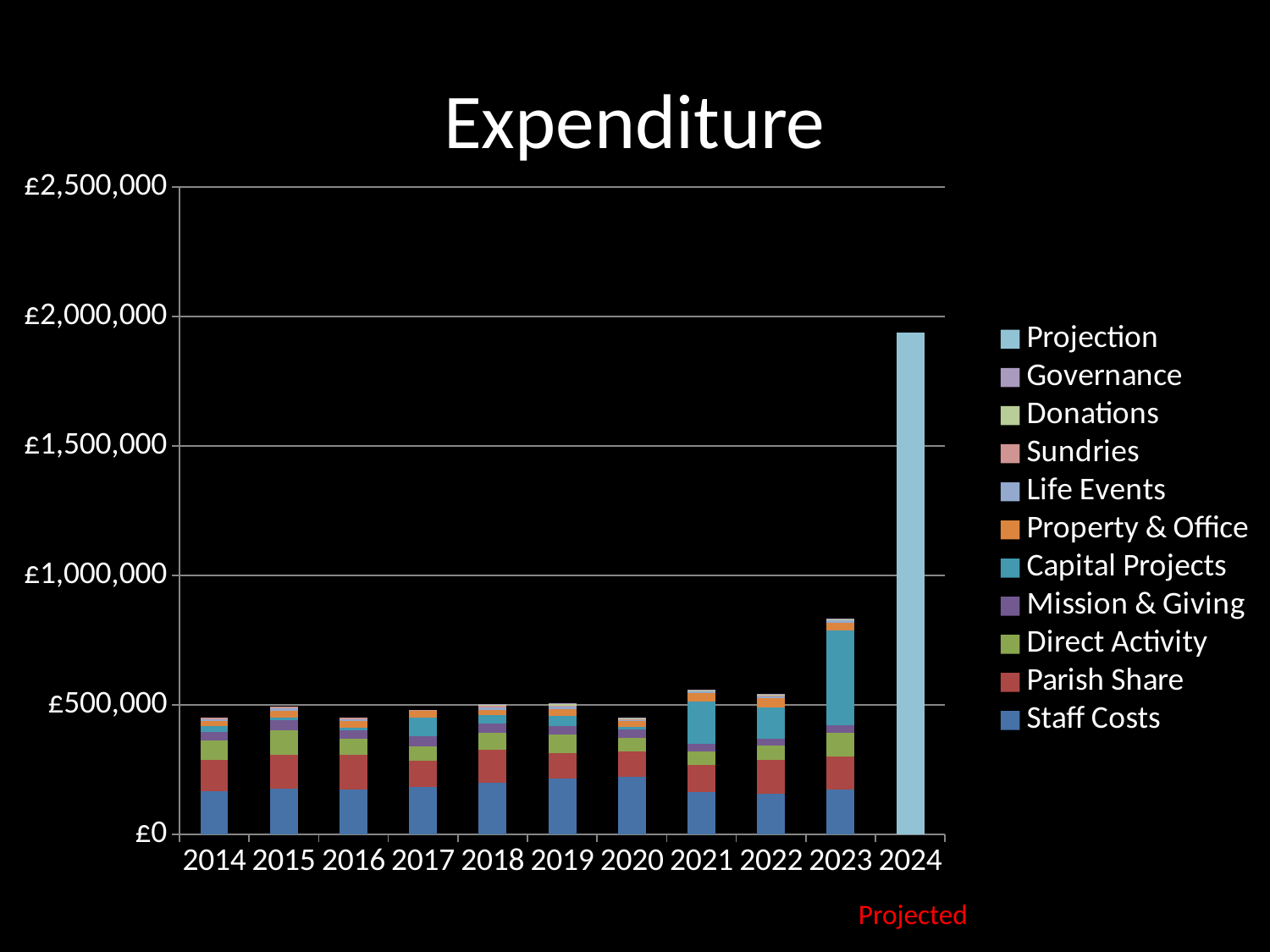
What is the title of the chart? Expenditure What kind of chart is shown on the slide? Stacked bar chart Which year has the larger total expenditure, 2022 or 2023? 2023 Is the total value for 2023 greater or less than £500,000? greater Is the value for 2024 greater or less than £1,500,000? greater Is the total value for 2020 greater or less than £500,000? less Which year on the chart is labelled as projected? 2024 Which year has the highest total expenditure? 2024 How many years are shown along the x axis of the chart? 11 Do the total expenditure values rise or fall from 2022 to 2024? rise How many series does the legend list? 11